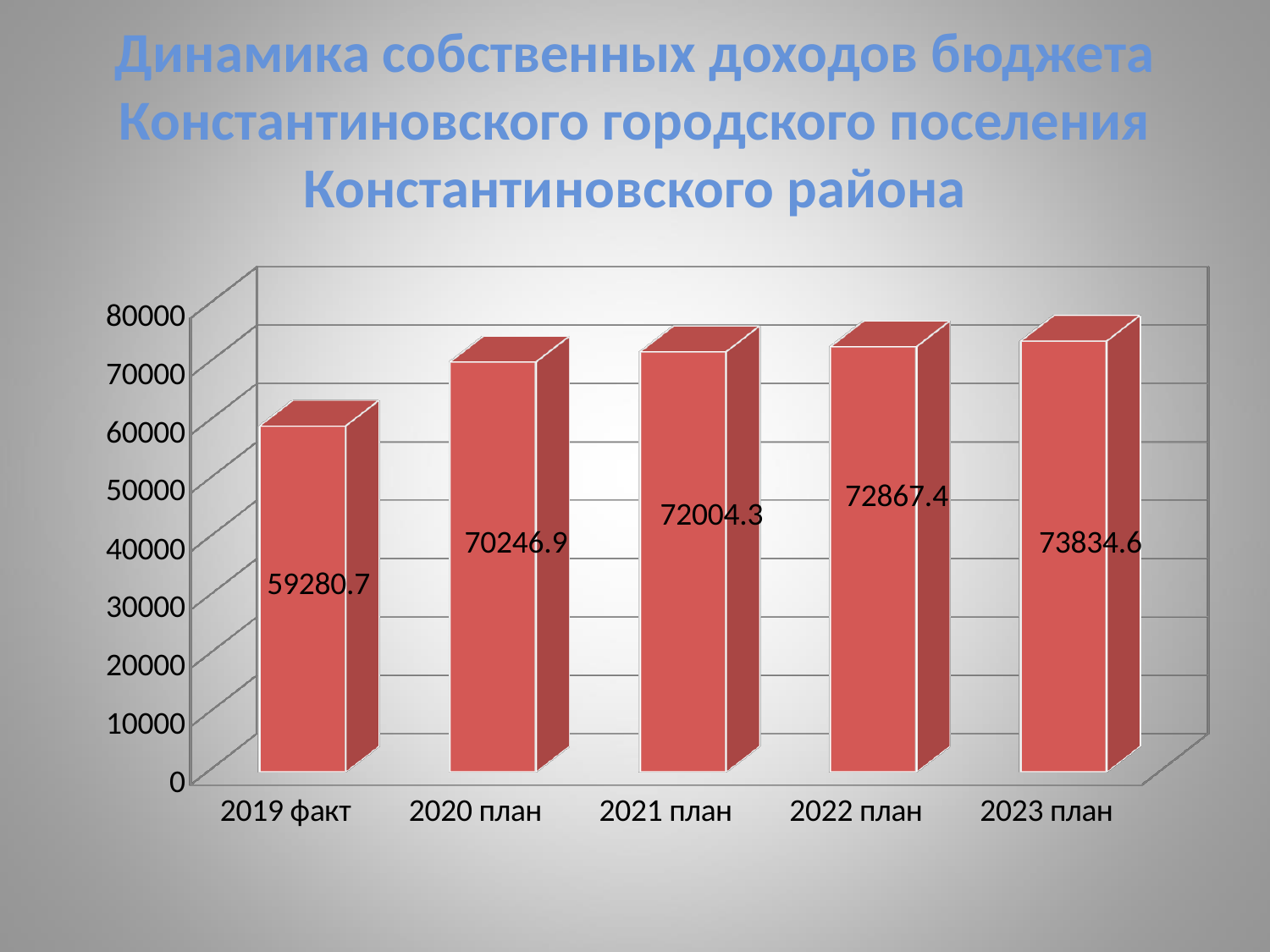
What kind of chart is shown on the slide? bar chart What is the difference between the values for 2023 план and 2019 факт? 14553.9 Which category has the highest value? 2023 план What is the value for 2021 план? 72004.3 Which is larger, the value for 2021 план or the value for 2022 план? 2022 план How many categories are shown on the x axis? 5 Do the values rise or fall from 2019 факт to 2023 план? rise Which category has the lowest value? 2019 факт Is the value for 2020 план greater or less than 60000? greater What is the difference between the values for 2020 план and 2019 факт? 10966.2 What is the value for 2019 факт? 59280.7 What is the value for 2023 план? 73834.6